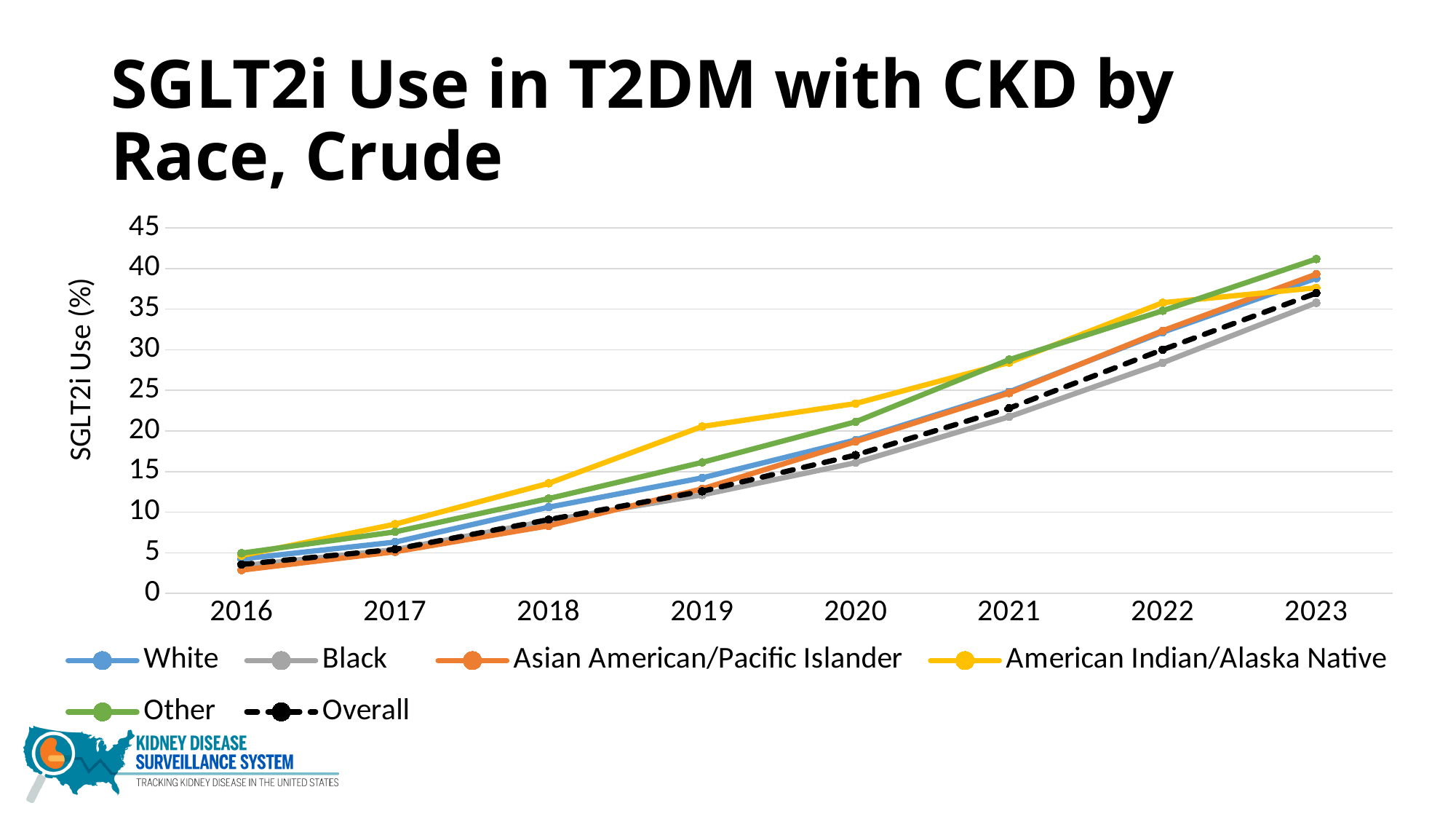
In 2021, which is larger: the value for Black or the value for Other? Other What is the label on the y axis? SGLT2i Use (%) Which series has the highest value in 2019? American Indian/Alaska Native Do the values for the Overall series rise or fall from 2016 to 2023? rise How many series does the legend list? 6 Which series has the highest value in 2023? Other Is the value for American Indian/Alaska Native in 2019 greater or less than 15? greater Is the value for Black in 2023 greater or less than 40? less Is the value for Other in 2023 greater or less than 40? greater Which series is drawn with a dashed black line? Overall What kind of chart is shown on the slide? line chart How many years are plotted along the x axis? 8